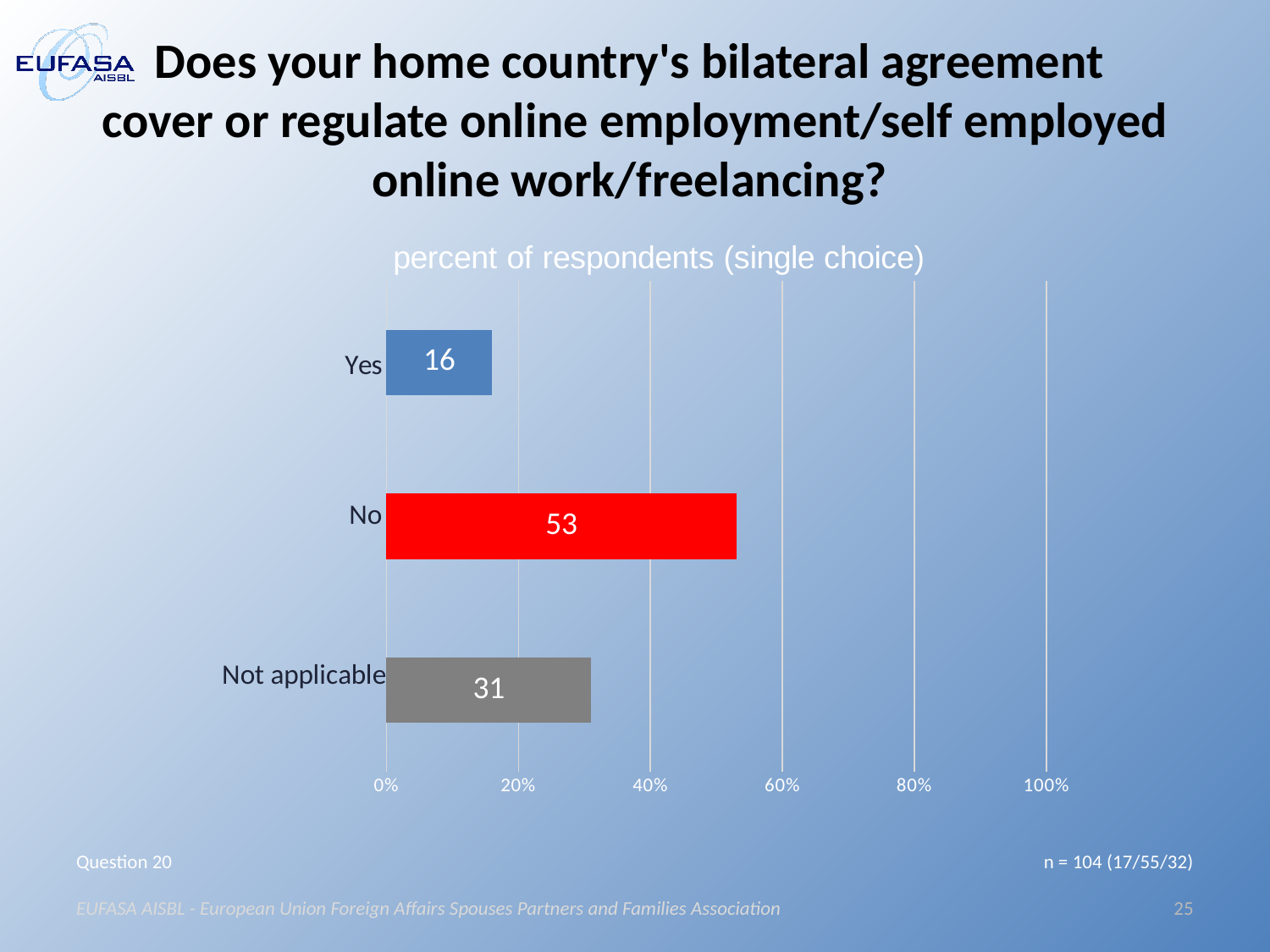
What is the difference between the values for "Not applicable" and "Yes"? 15 What is the value for "Yes"? 16 What is the difference between the values for "No" and "Not applicable"? 22 What kind of chart is shown on the slide? bar chart What is the value for "No"? 53 How many categories are shown in the chart? 3 Which category has the highest value? No What is the title of the chart? percent of respondents (single choice) Which is larger, the value for "Yes" or the value for "Not applicable"? Not applicable Is the value for "No" greater or less than 40%? greater Which category has the lowest value? Yes What is the value for "Not applicable"? 31